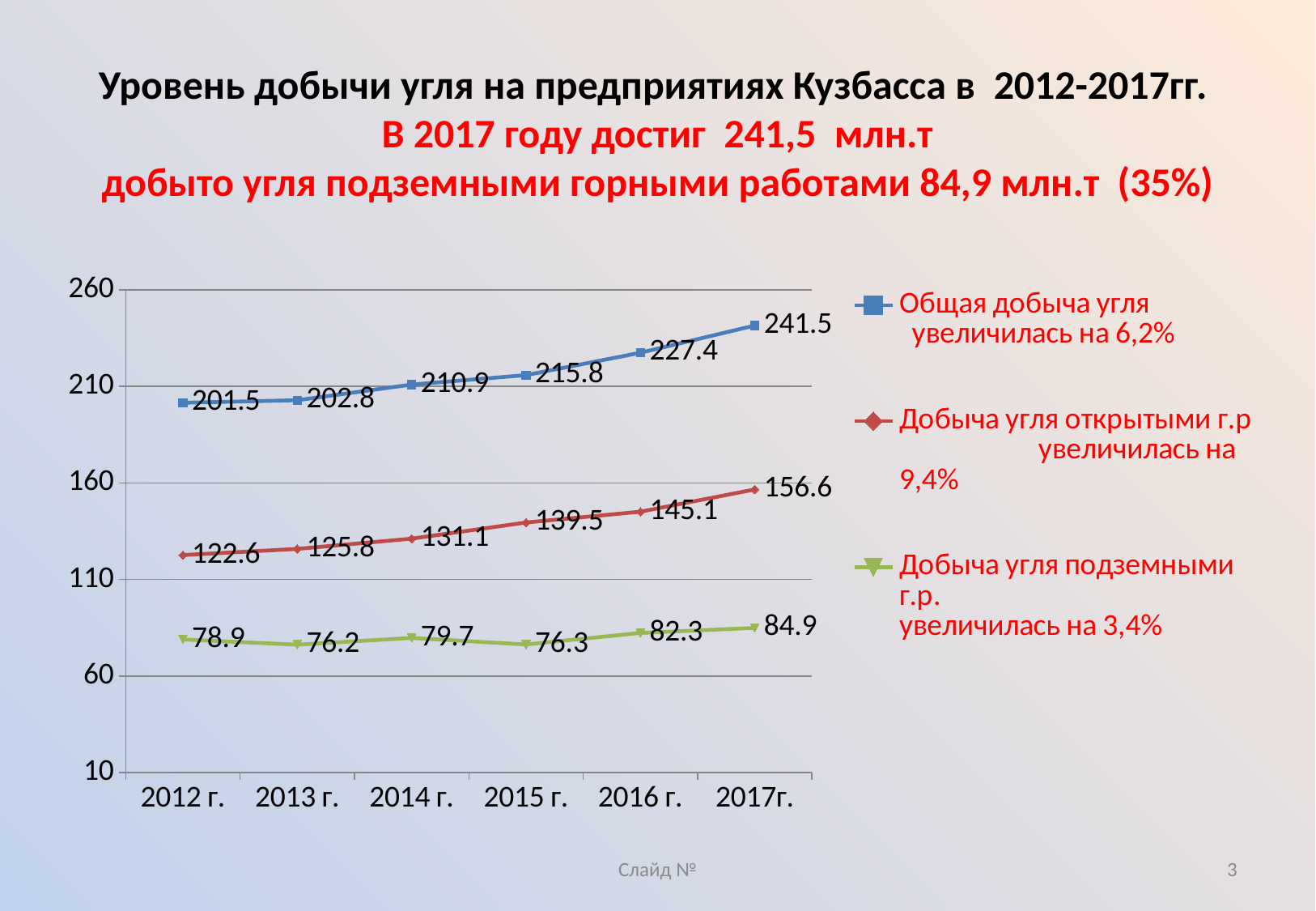
Does total coal production (Общая добыча угля) rise or fall from 2012 to 2017? rises Which is larger: open-pit production in 2016 or underground production in 2016? open-pit production (145.1) What colour is the line for total coal production (Общая добыча угля)? blue In which year was underground coal production (Добыча угля подземными г.р.) the lowest? 2013 г. What is the value of open-pit coal production (Добыча угля открытыми г.р) in 2014? 131.1 By how much did total coal production (Общая добыча угля) increase from 2012 to 2017? 40.0 What type of chart is shown on the slide? line chart In which year was open-pit coal production (Добыча угля открытыми г.р) the highest? 2017г. How many years are plotted along the x axis? 6 What is the value of total coal production (Общая добыча угля) in 2017? 241.5 What is the value of underground coal production (Добыча угля подземными г.р.) in 2013? 76.2 How many series does the legend list? 3